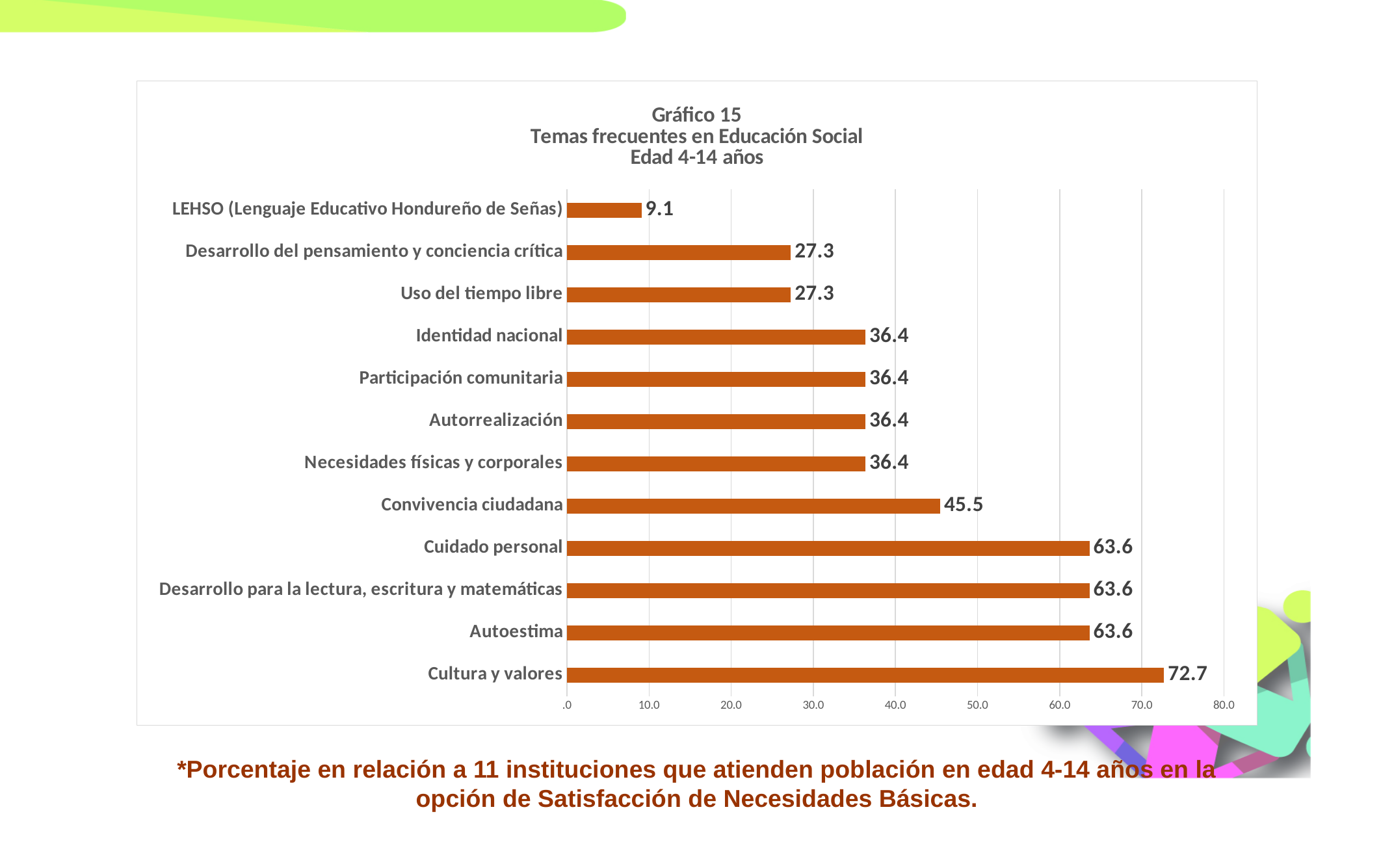
What is the value for Cultura y valores? 72.7 Which category has the highest value? Cultura y valores What is the difference between the values for Convivencia ciudadana and Uso del tiempo libre? 18.2 What is the value for LEHSO (Lenguaje Educativo Hondureño de Señas)? 9.1 Which category has the lowest value? LEHSO (Lenguaje Educativo Hondureño de Señas) What is the difference between the values for Cultura y valores and Autoestima? 9.1 What is the title of the chart? Gráfico 15 Temas frecuentes en Educación Social Edad 4-14 años What kind of chart is shown on the slide? Bar chart What is the value for Convivencia ciudadana? 45.5 What is the value for Identidad nacional? 36.4 How many categories are shown in the chart? 12 Which is larger, the value for Cuidado personal or the value for Convivencia ciudadana? Cuidado personal